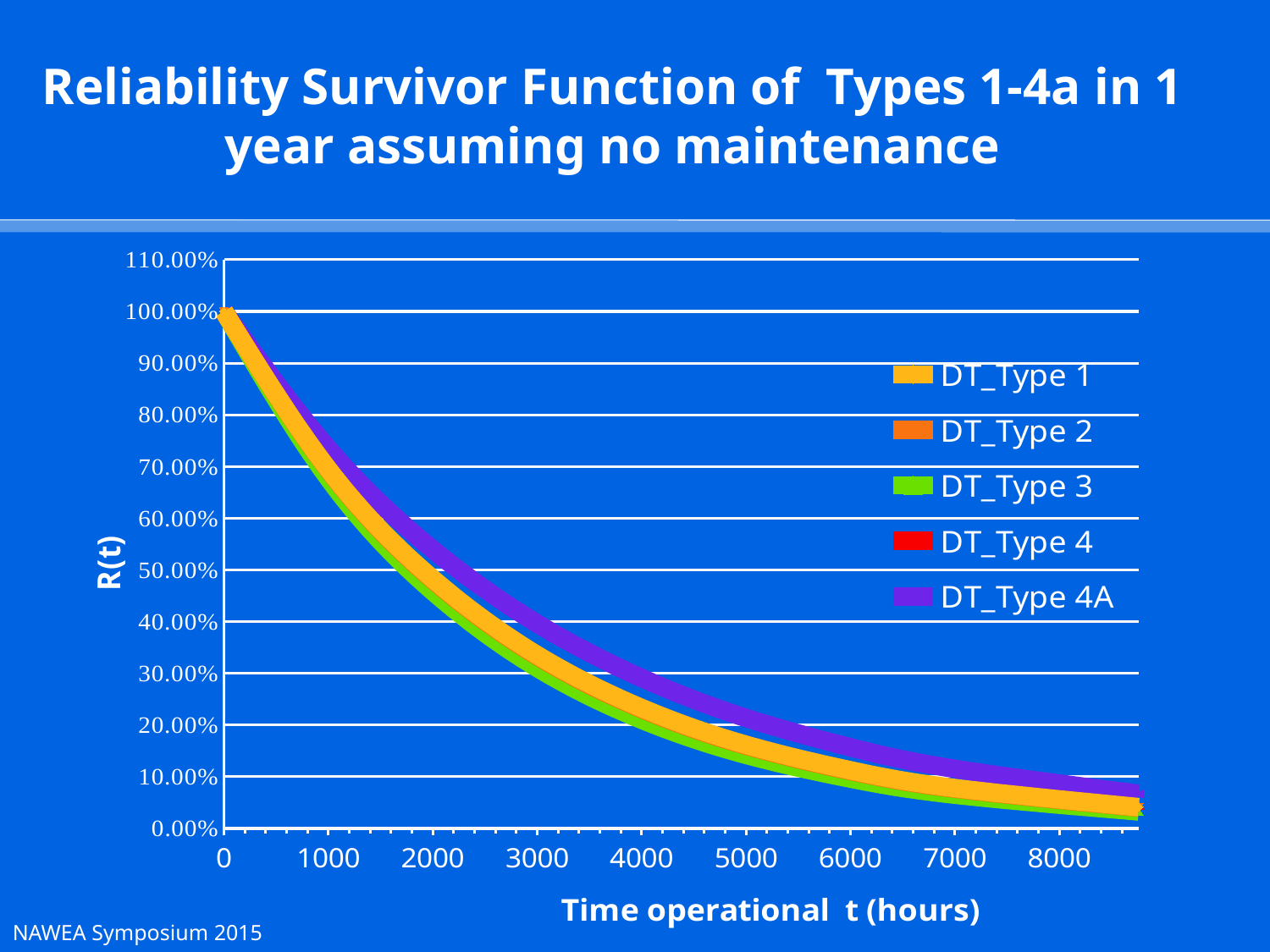
Is the value of R(t) for DT_Type 4A at 2000 hours greater or less than 50.00%? greater How many series does the legend list? 5 Which series has the highest R(t) at 8000 hours? DT_Type 4A Do the R(t) values rise or fall as time operational increases? fall What kind of chart is shown on the slide? line chart What colour is the DT_Type 4A series in the legend? purple Is the value of R(t) for DT_Type 3 at 8000 hours greater or less than 10.00%? less What is the label of the x axis? Time operational t (hours) Is the value of R(t) for DT_Type 4A at 6000 hours greater or less than 10.00%? greater At 4000 hours, which is larger: R(t) for DT_Type 4A or for DT_Type 1? DT_Type 4A What is the value of R(t) for all types at t = 0 hours? 100.00%